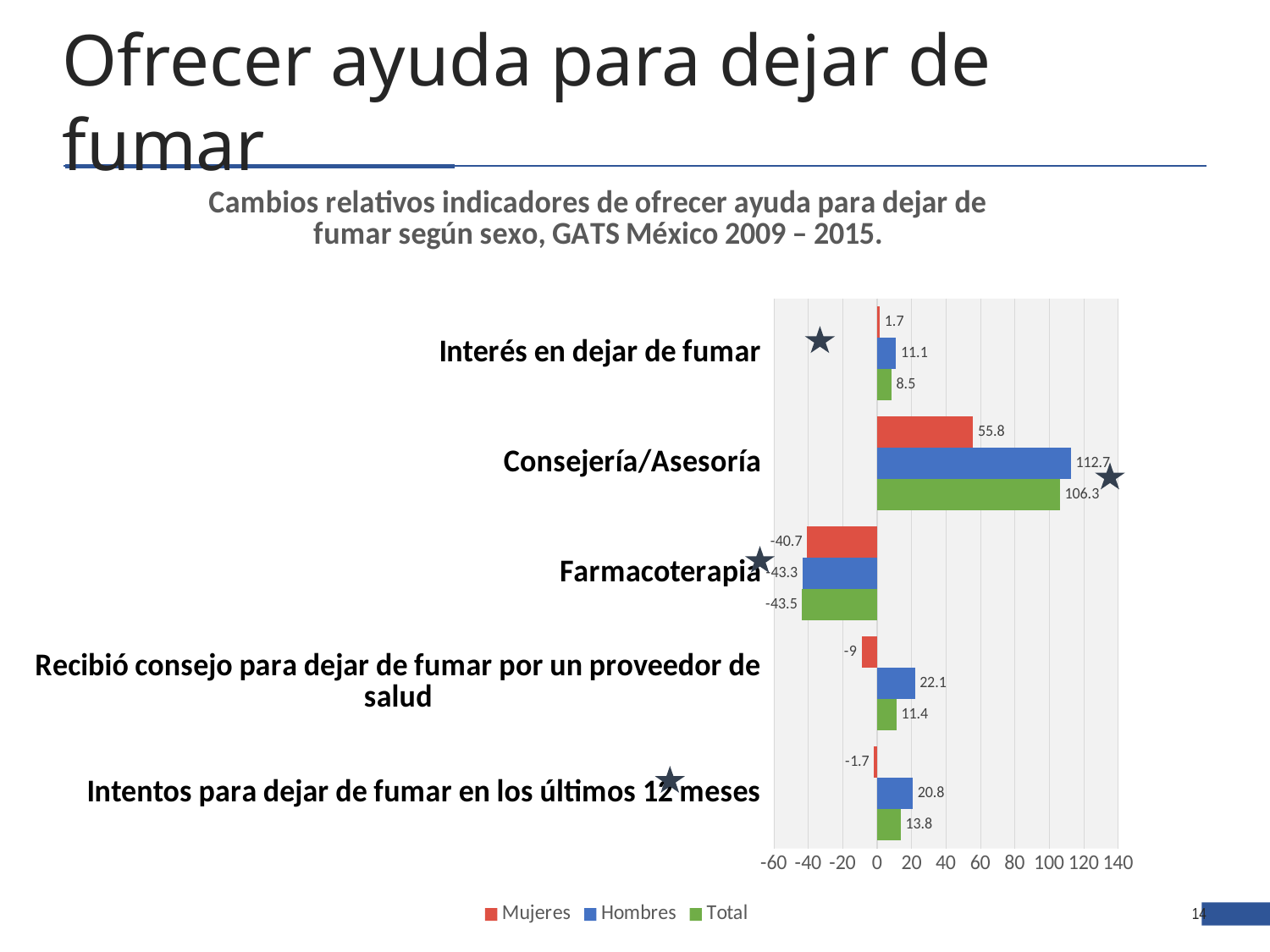
Which colour represents the Total series in the chart? Green What is the Hombres value for Consejería/Asesoría? 112.7 What kind of chart is shown on the slide? Bar chart What is the difference between the Hombres and Mujeres values for Consejería/Asesoría? 56.9 Which is larger for Interés en dejar de fumar, the Hombres value or the Total value? Hombres What is the Mujeres value for Recibió consejo para dejar de fumar por un proveedor de salud? -9 What is the Total value for Farmacoterapia? -43.5 How many categories are shown on the chart? 5 Which category has the highest Hombres value? Consejería/Asesoría Which category has the lowest Mujeres value? Farmacoterapia What is the Total value for Intentos para dejar de fumar en los últimos 12 meses? 13.8 How many series does the legend list? 3